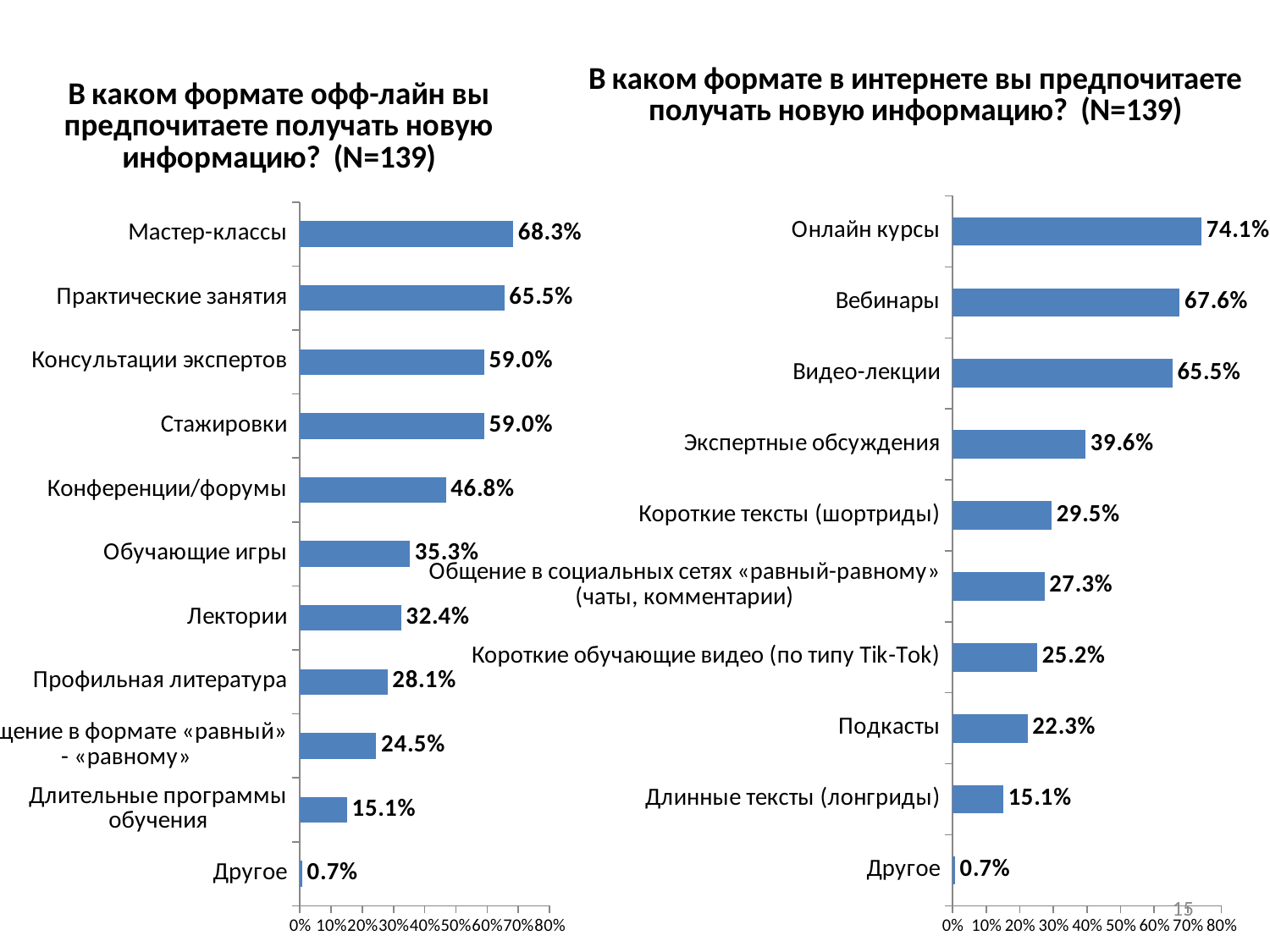
In the right chart (internet formats), what is the value for Длинные тексты (лонгриды)? 15.1% In the right chart (internet formats), which is larger: Подкасты or Короткие тексты (шортриды)? Короткие тексты (шортриды) In the right chart (internet formats), which category has the highest value? Онлайн курсы How many categories are shown in the right chart (internet formats)? 10 How many categories are shown in the left chart (offline formats)? 11 In the left chart (offline formats), what is the value for Мастер-классы? 68.3% In the left chart (offline formats), which category has the lowest value? Другое In the right chart (internet formats), what is the value for Вебинары? 67.6% In the left chart (offline formats), what is the value for Стажировки? 59.0% What type of chart is the left chart (offline formats)? Bar chart In the left chart (offline formats), what is the difference between Мастер-классы and Практические занятия? 2.8% In the left chart (offline formats), is the value for Конференции/форумы greater or less than 50%? less